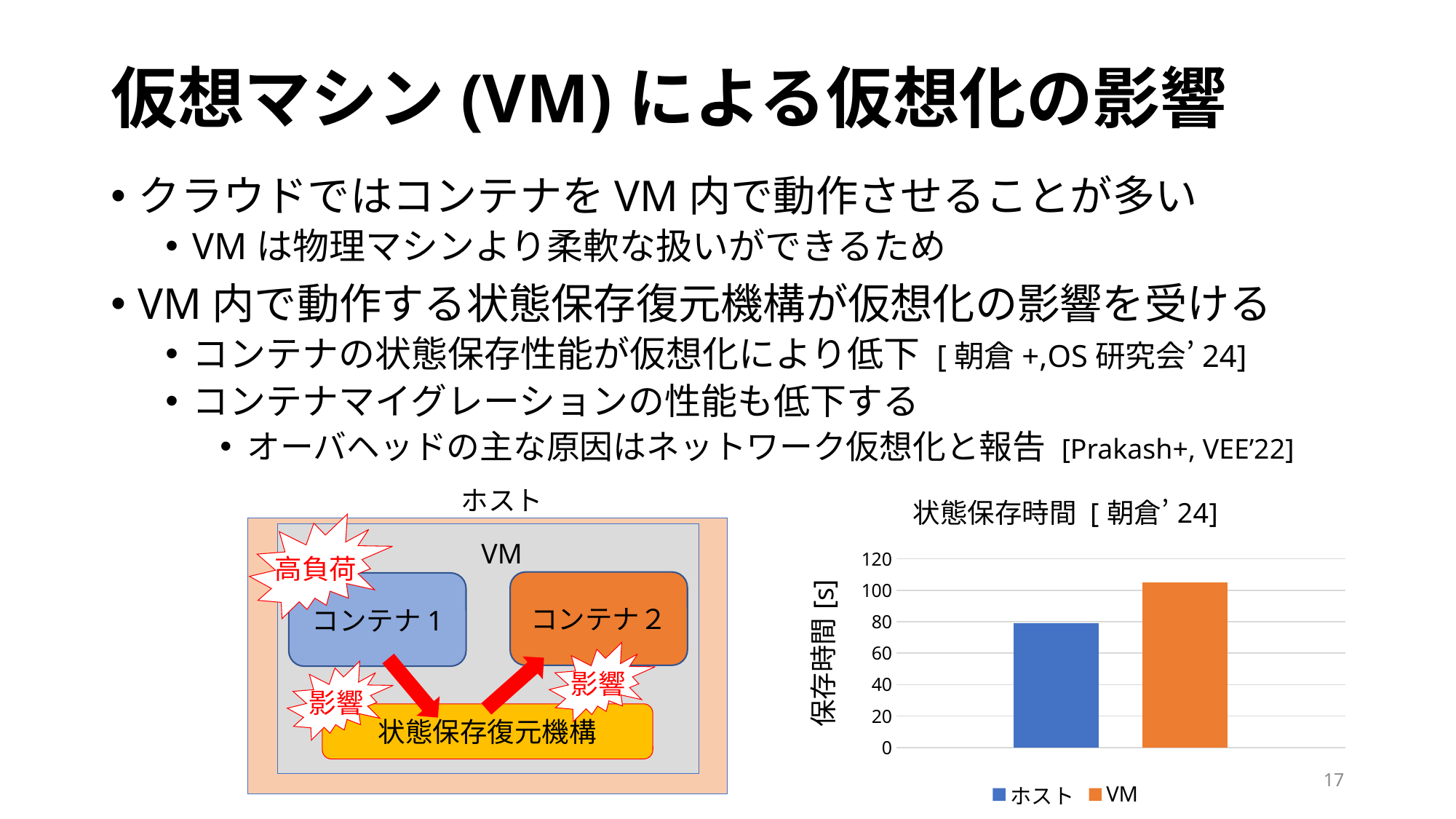
Is the value for VM greater or less than 80? greater Is the value for ホスト greater or less than 60? greater Is the value for ホスト greater or less than 100? less What is the label of the vertical axis of the chart? 保存時間 [s] How many bars are plotted in the chart? 2 Which series has the lowest value in the chart? ホスト Which series has the higher bar in the chart, ホスト or VM? VM What is the title of the chart on the slide? 状態保存時間 [朝倉'24] How many series does the chart's legend list? 2 What kind of chart is shown on the right side of the slide? bar chart Which series has the highest value in the chart? VM